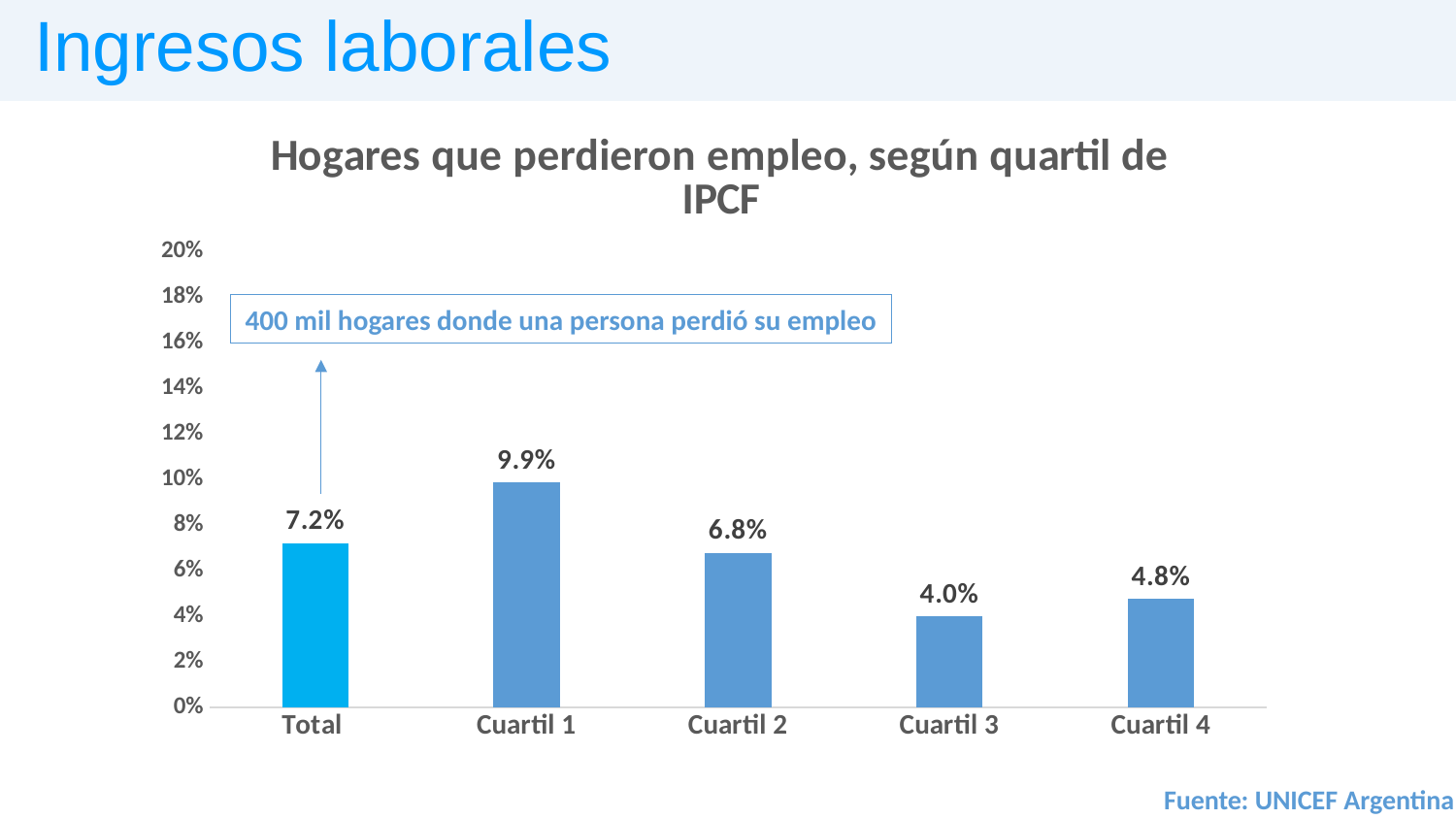
What is the value for Cuartil 1? 9.9% Is the value for Cuartil 1 greater or less than 8%? greater How many categories are shown on the x axis? 5 Which is larger, the value for Cuartil 2 or the value for Cuartil 4? Cuartil 2 What is the value for Total? 7.2% What kind of chart is shown on the slide? bar chart What does the text box above the Total bar say? 400 mil hogares donde una persona perdió su empleo What is the title of the chart? Hogares que perdieron empleo, según quartil de IPCF Which category has the highest value? Cuartil 1 What is the value for Cuartil 3? 4.0% What is the difference between the values for Cuartil 1 and Cuartil 4? 5.1% Which category has the lowest value? Cuartil 3